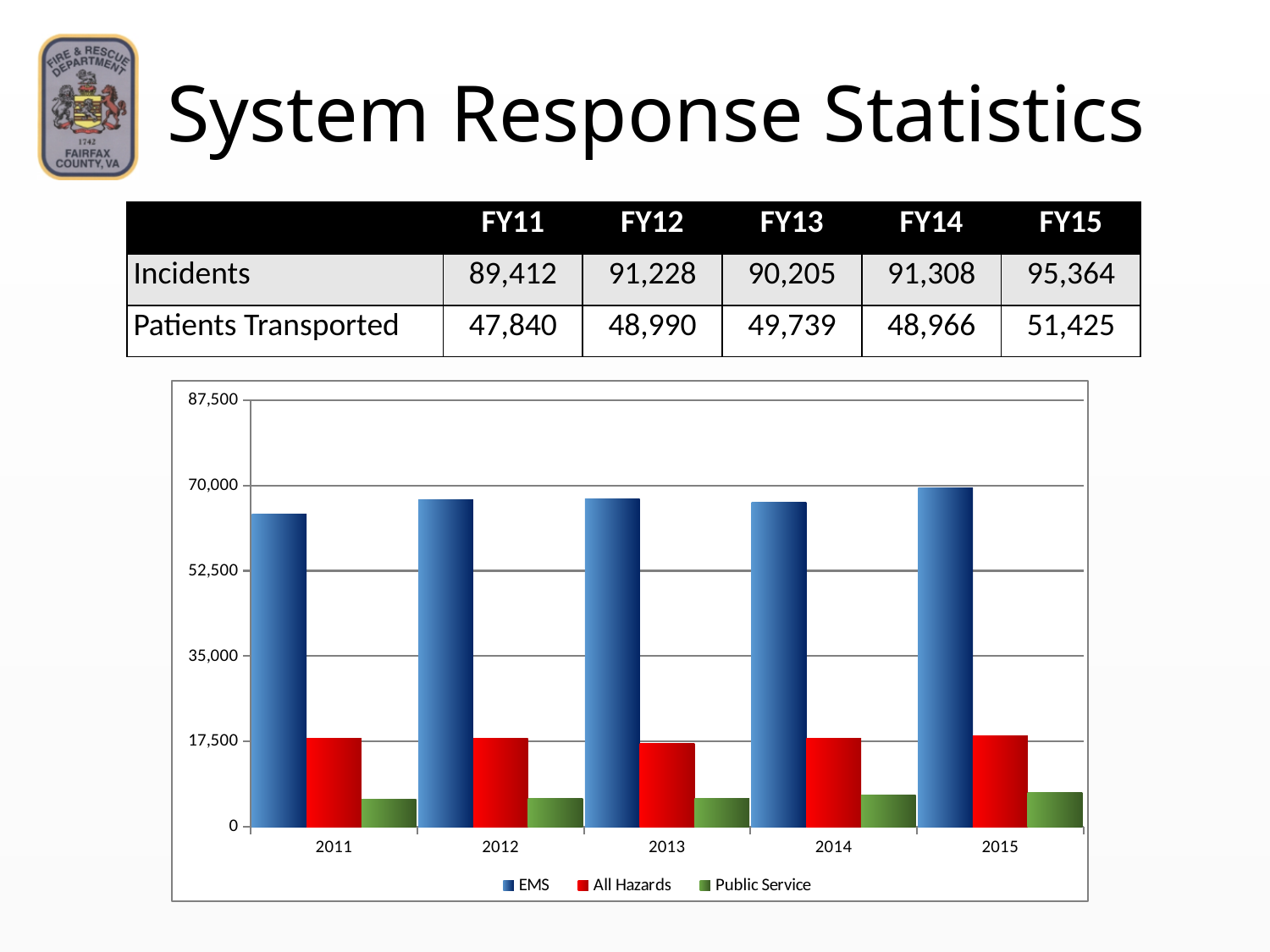
Is the Public Service value for 2015 greater or less than 17,500? less How many years are shown along the x axis of the chart? 5 Which year has the highest EMS bar in the chart? 2015 Is the EMS value for 2011 greater or less than 70,000? less In 2015, which is larger: the All Hazards value or the Public Service value? All Hazards What kind of chart is shown on the slide? bar chart Is the All Hazards value for 2013 greater or less than 35,000? less In 2011, which is larger: the EMS value or the All Hazards value? EMS Which year has the lowest EMS bar in the chart? 2011 What are the three series named in the chart's legend? EMS, All Hazards, Public Service How many series does the chart's legend list? 3